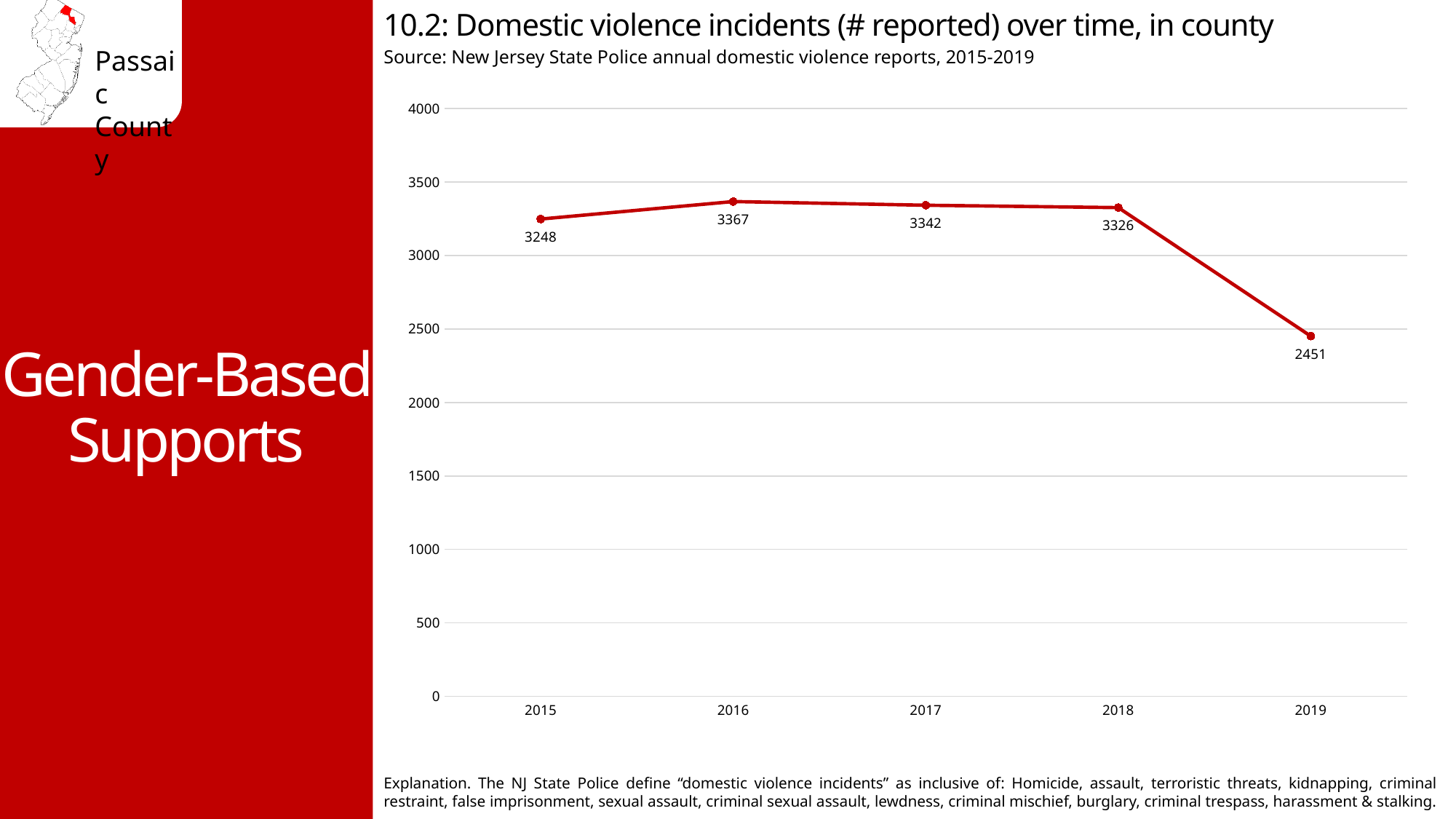
What is the number of reported domestic violence incidents in 2017? 3342 What is the difference between the number of incidents in 2016 and 2015? 119 What is the number of reported domestic violence incidents in 2019? 2451 What kind of chart is shown on the slide? line chart Which year had more reported incidents, 2017 or 2018? 2017 Which year has the highest number of reported domestic violence incidents? 2016 What is the difference between the number of incidents in 2018 and 2019? 875 Do the values rise or fall from 2018 to 2019? fall What is the number of reported domestic violence incidents in 2015? 3248 Which year has the lowest number of reported domestic violence incidents? 2019 Is the value for 2019 greater or less than 3000? less How many years are plotted on the chart? 5